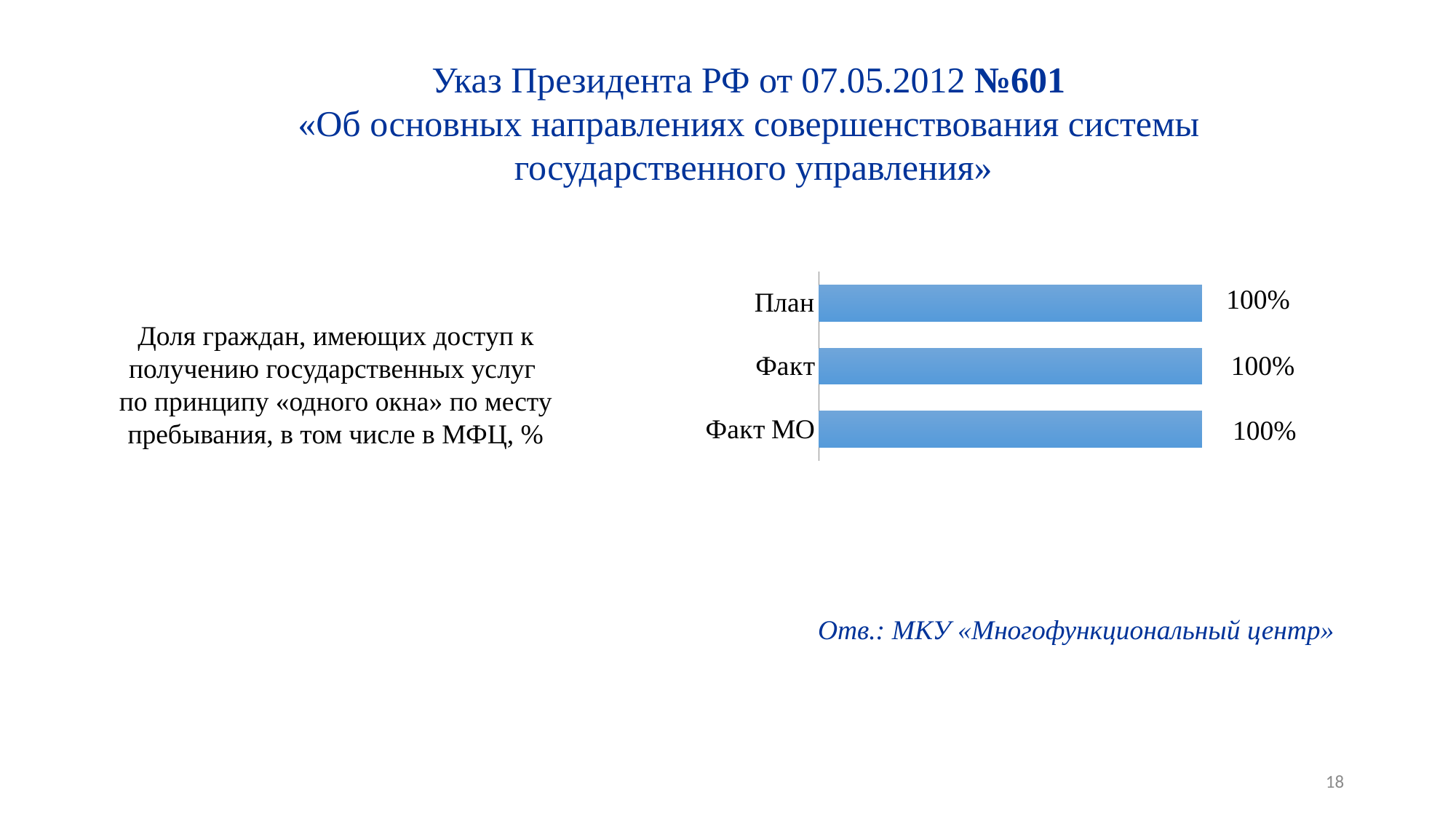
What is the difference between the values for Факт and Факт МО? 0% How many categories are shown in the chart? 3 What is the value for План? 100% Are the bars in the chart horizontal or vertical? Horizontal Do all three categories in the chart have the same value? Yes What is the difference between the values for План and Факт? 0% What kind of chart is shown on the slide? Bar chart What is the value for Факт МО? 100% What is the value for Факт? 100% Which category is listed at the top of the chart? План What colour are the bars in the chart? Blue